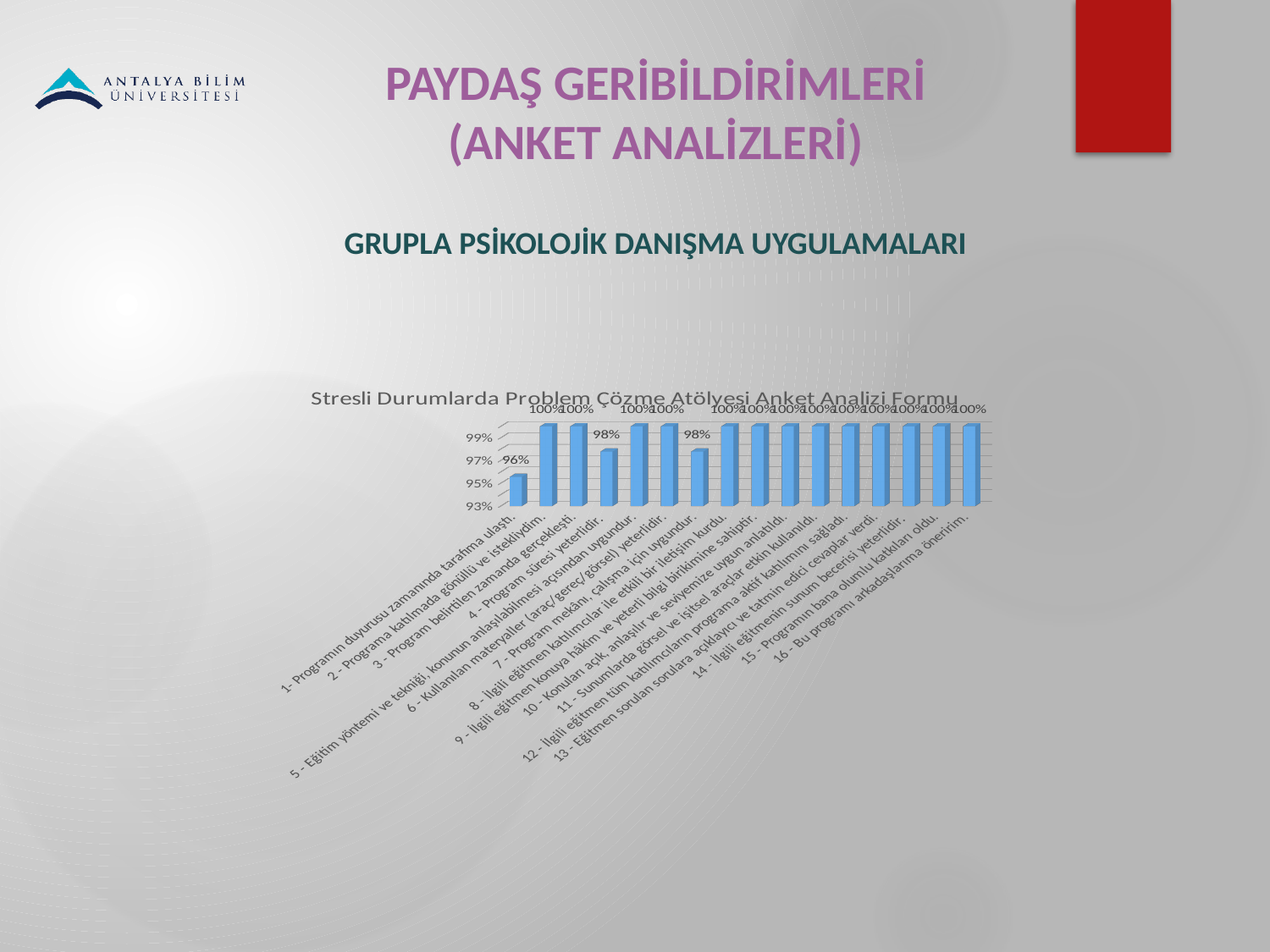
How many categories in the chart have a value of 100%? 13 Which is larger: the value for "4 - Program süresi yeterlidir." or the value for "5 - Eğitim yöntemi ve tekniği, konunun anlaşılabilmesi açısından uygundur."? 5 - Eğitim yöntemi ve tekniği, konunun anlaşılabilmesi açısından uygundur. Which category has the lowest value in the chart? 1- Programın duyurusu zamanında tarafıma ulaştı. How many categories (survey items) are plotted in the chart? 16 What is the value for "1- Programın duyurusu zamanında tarafıma ulaştı."? 96% What is the difference between the value for "2 - Programa katılmada gönüllü ve istekliydim." and the value for "1- Programın duyurusu zamanında tarafıma ulaştı."? 4% What is the value for "7 - Program mekanı, çalışma için uygundur."? 98% What is the value for "4 - Program süresi yeterlidir."? 98% What is the title of the chart? Stresli Durumlarda Problem Çözme Atölyesi Anket Analizi Formu What is the value for "16 - Bu programı arkadaşlarıma öneririm."? 100% What type of chart is shown on the slide? bar chart Is the value for "1- Programın duyurusu zamanında tarafıma ulaştı." greater or less than 97%? less